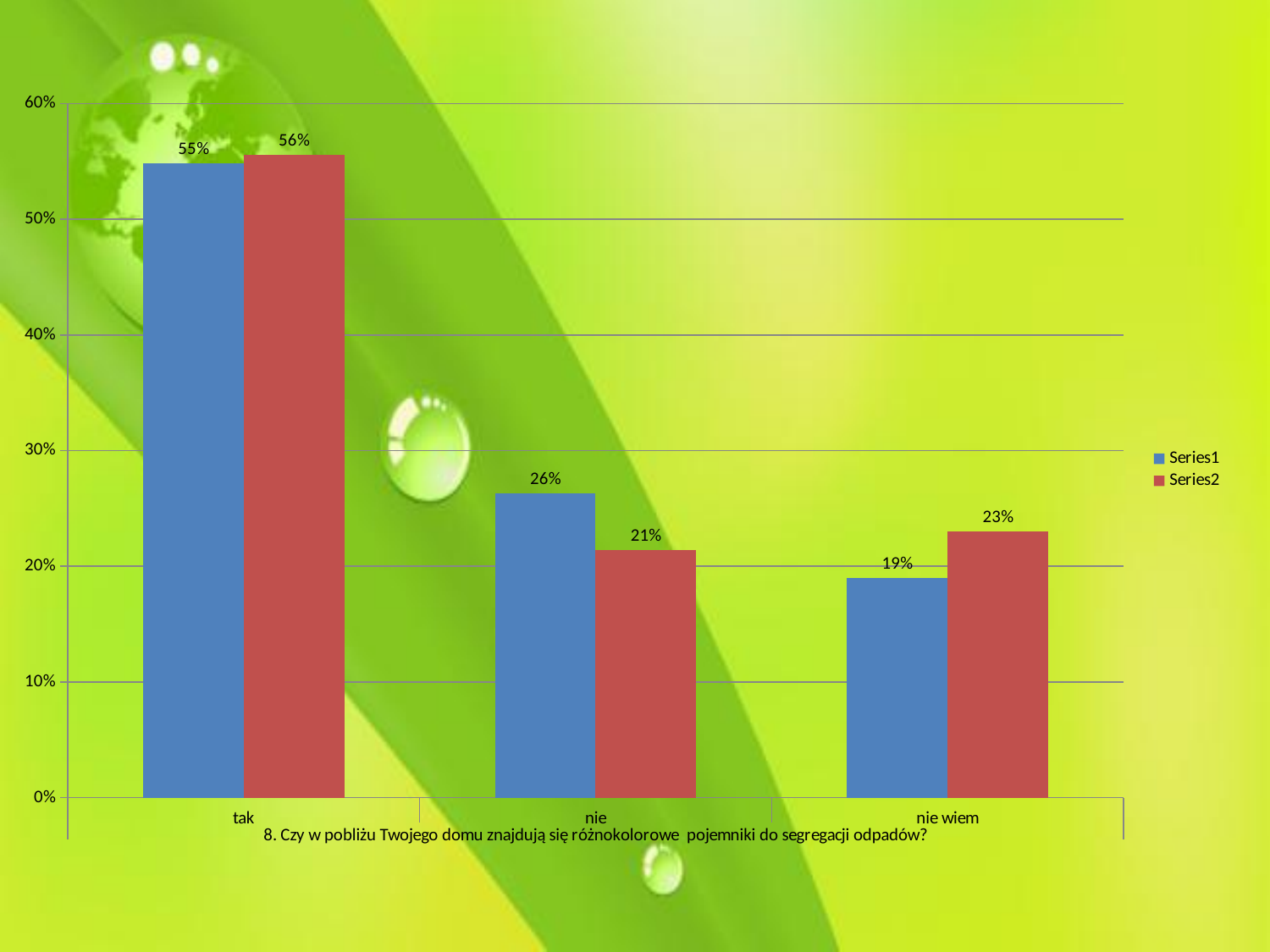
What is the difference between Series1 and Series2 for "nie"? 5% What is the value of Series1 for "tak"? 55% How many series does the legend list? 2 What is the value of Series2 for "nie"? 21% Which category has the highest value for Series1? tak What colour are the Series2 bars? red How many categories are shown on the x axis? 3 Which category has the lowest value for Series2? nie What is the value of Series2 for "nie wiem"? 23% For "nie wiem", which series has the larger value, Series1 or Series2? Series2 What kind of chart is shown on the slide? bar chart Is the value of Series1 for "nie" greater or less than 30%? less